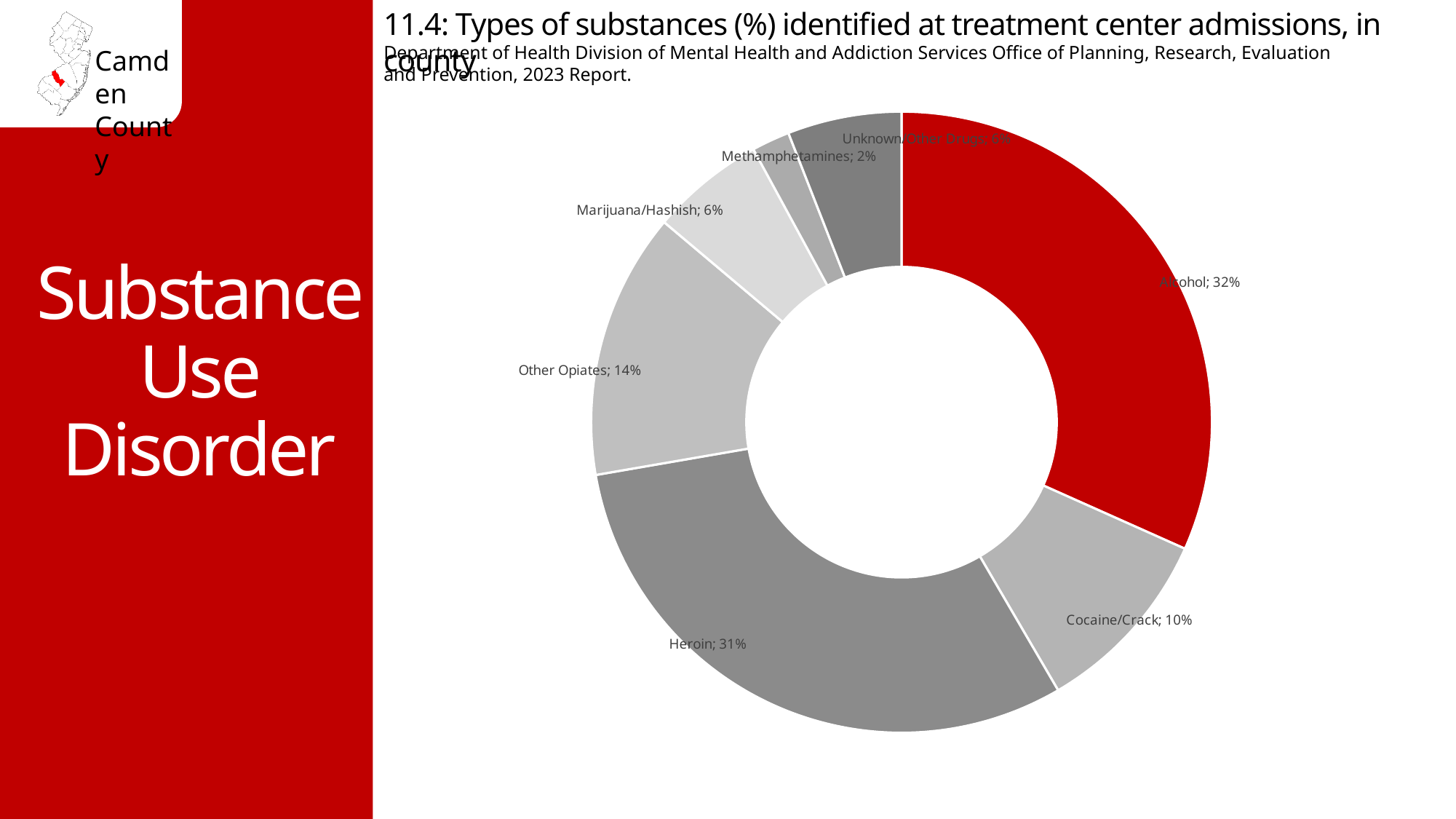
What percentage is shown for Heroin? 31% What is the difference in percentage points between Other Opiates and Marijuana/Hashish? 8 Which has a larger share, Heroin or Other Opiates? Heroin What percentage of treatment center admissions is attributed to Alcohol? 32% What kind of chart is shown on the slide? doughnut chart Which substance has the largest share of admissions? Alcohol What colour is the Alcohol slice of the chart? red Which substance has the smallest share of admissions? Methamphetamines How many substance categories are shown in the chart? 7 What percentage is shown for Other Opiates? 14% What is the difference in percentage points between Alcohol and Cocaine/Crack? 22 What percentage is shown for Cocaine/Crack? 10%